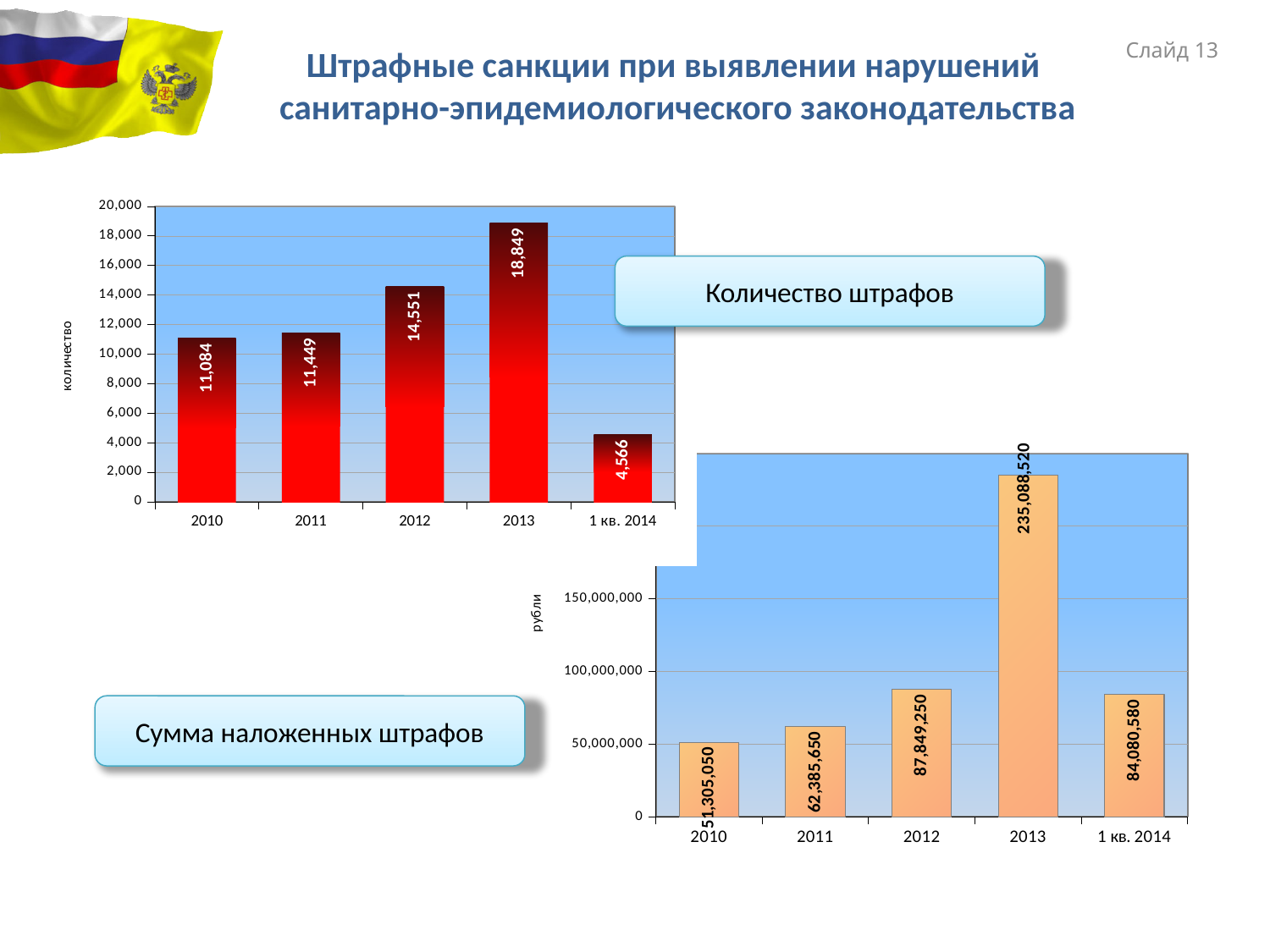
In the 'Количество штрафов' chart, what is the value for 2013? 18,849 In the 'Количество штрафов' chart, which category has the lowest value? 1 кв. 2014 What is the y-axis label of the 'Сумма наложенных штрафов' chart? рубли What type of chart is the 'Сумма наложенных штрафов' chart? bar chart In the 'Количество штрафов' chart, what is the value for 1 кв. 2014? 4,566 In the 'Количество штрафов' chart, which year has the highest value? 2013 In the 'Сумма наложенных штрафов' chart, is the value for 2011 greater or less than 50,000,000? greater In the 'Количество штрафов' chart, what is the difference between the values for 2012 and 2011? 3,102 In the 'Сумма наложенных штрафов' chart, what is the value for 2013? 235,088,520 In the 'Количество штрафов' chart, how many categories are shown on the x axis? 5 In the 'Сумма наложенных штрафов' chart, which is larger, the value for 2012 or the value for 1 кв. 2014? 2012 In the 'Сумма наложенных штрафов' chart, what is the value for 2012? 87,849,250